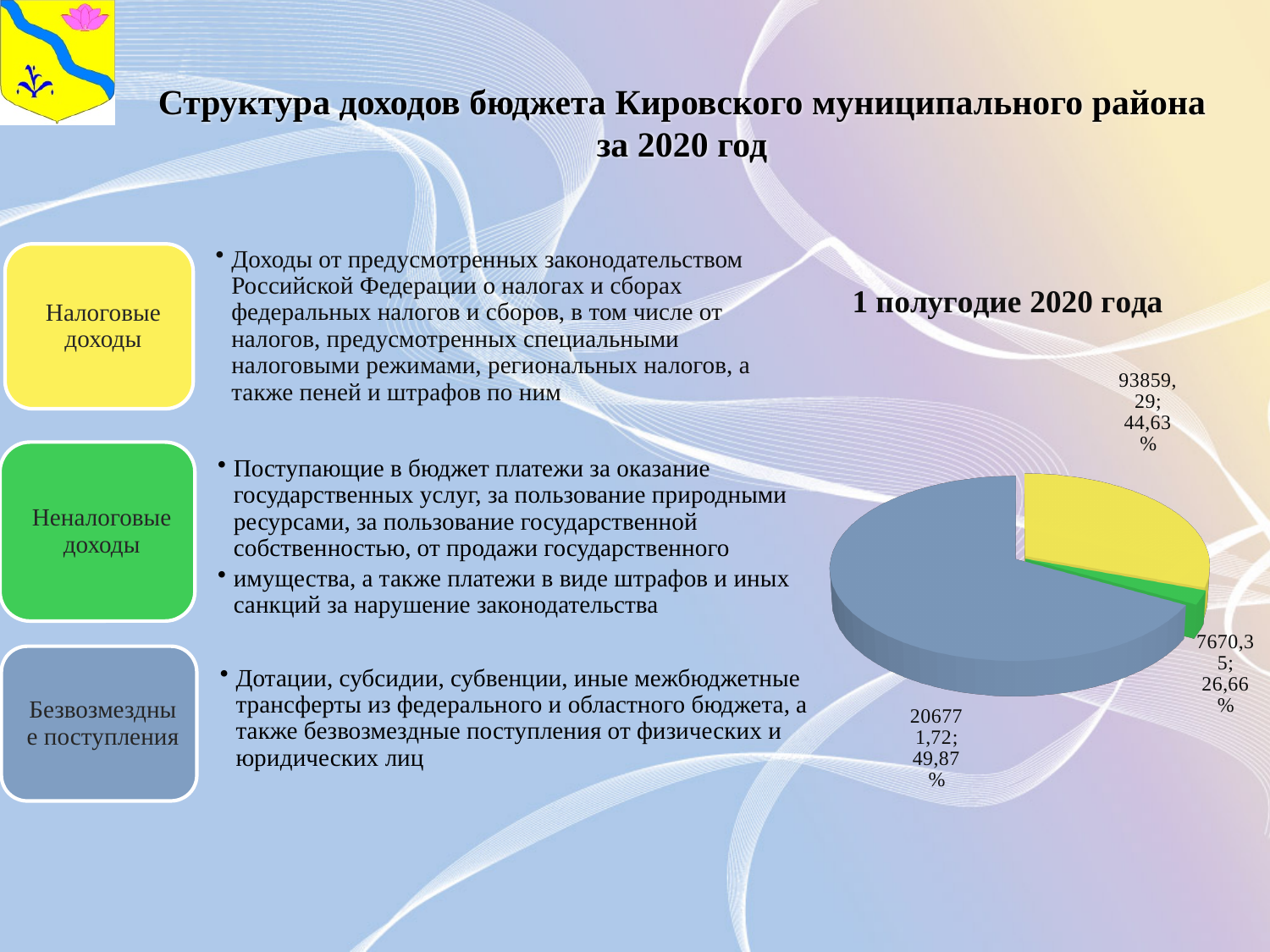
What colour is the slice labelled 93859,29; 44,63%? yellow Which slice of the pie chart is the smallest? the green slice (7670,35; 26,66%) How many slices does the pie chart have? 3 What percentage is shown on the yellow slice of the pie chart? 44,63% What value is printed on the green slice of the pie chart? 7670,35 What kind of chart is shown on the slide? pie chart What value is printed on the blue slice of the pie chart? 206771,72 What percentage is shown on the blue slice of the pie chart? 49,87% What is the title of the pie chart? 1 полугодие 2020 года What is the difference between the value on the yellow slice and the value on the green slice? 86188,94 Which is larger in the pie chart, the yellow slice or the green slice? the yellow slice Which slice of the pie chart is the largest? the blue slice (206771,72; 49,87%)